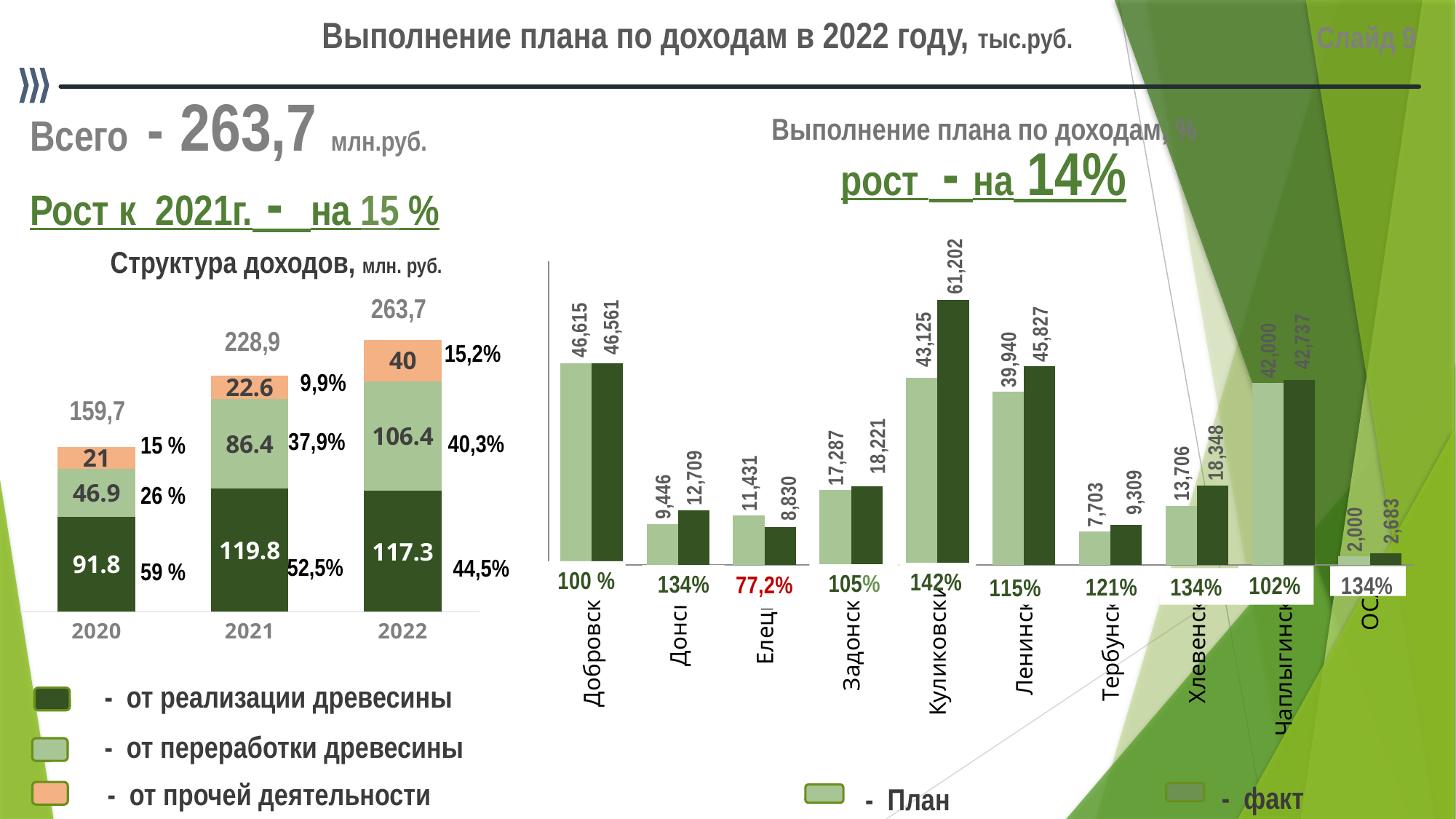
In the chart 'Структура доходов', how many years are shown on the x axis? 3 In the chart 'Структура доходов', which year has the highest total? 2022 In the chart 'Выполнение плана по доходам, %', what is the 'План' value for Задонск? 17,287 In the chart 'Структура доходов', what is the total of the stacked bar for 2021? 228,9 In the chart 'Выполнение плана по доходам, %', how many series does the legend list? 2 In the chart 'Структура доходов', what is the value for 'от реализации древесины' in 2022? 117.3 In the chart 'Структура доходов', do the values for 'от переработки древесины' rise or fall from 2020 to 2022? rise In the chart 'Структура доходов', what is the difference between the 'от переработки древесины' values for 2022 and 2021? 20 In the chart 'Выполнение плана по доходам, %', which is larger for Елец, 'План' or 'факт'? План What kind of chart is 'Выполнение плана по доходам, %' on the right? bar chart In the chart 'Структура доходов', how many series does the legend list? 3 In the chart 'Выполнение плана по доходам, %', which district has the highest 'факт' value? Куликовский